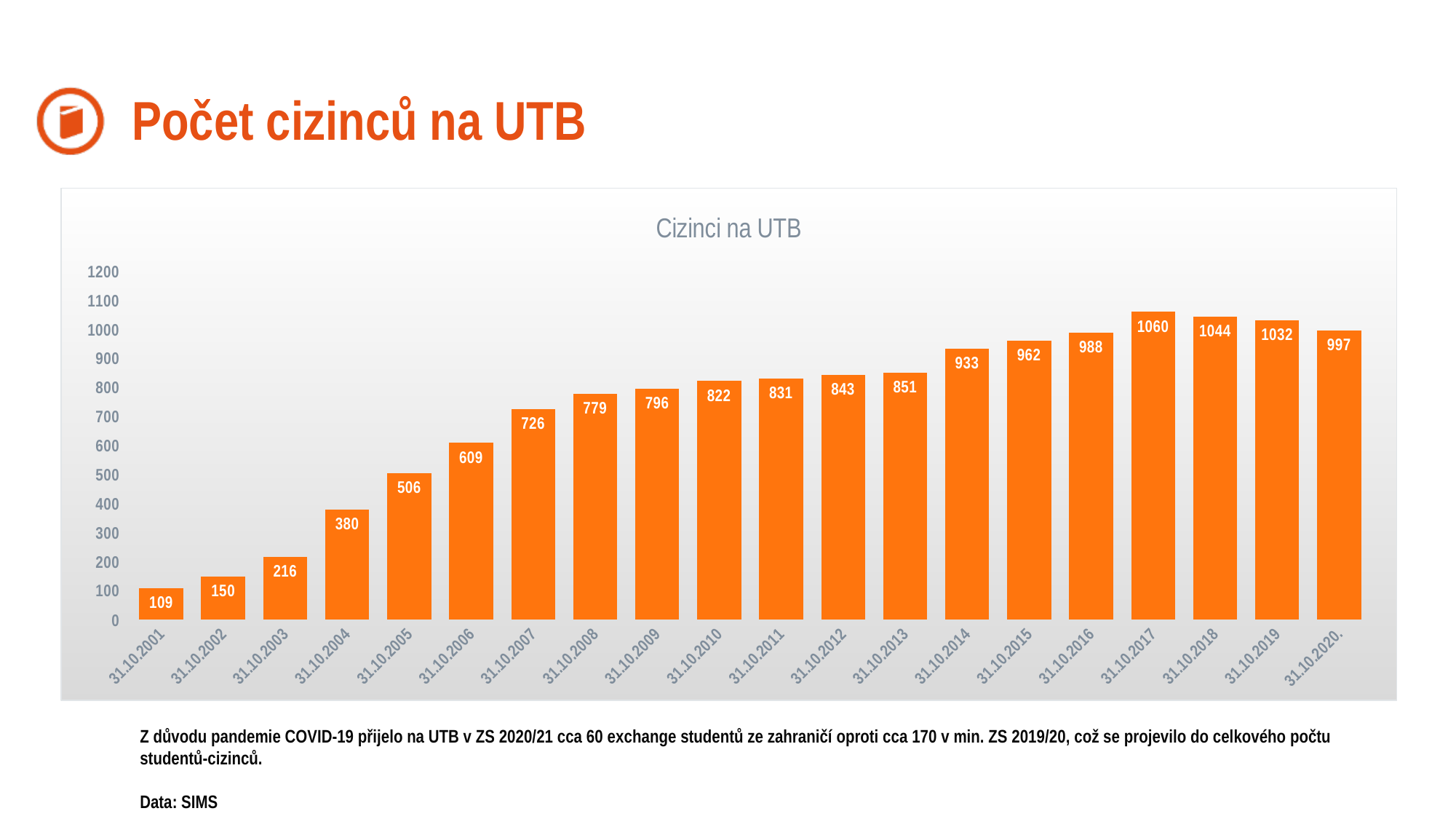
How many bars are shown in the chart? 20 What is the difference between the values for 31.10.2006 and 31.10.2005? 103 What is the difference between the values for 31.10.2017 and 31.10.2020.? 63 What kind of chart is shown on the slide? bar chart Do the values generally rise or fall from 31.10.2001 to 31.10.2017? rise What is the value for 31.10.2004 in the chart? 380 Which date has the highest value in the chart? 31.10.2017 What is the value for 31.10.2020. in the chart? 997 Which is larger, the value for 31.10.2018 or the value for 31.10.2019? 31.10.2018 Which date has the lowest value in the chart? 31.10.2001 What is the value for 31.10.2010 in the chart? 822 What is the title of the chart? Cizinci na UTB